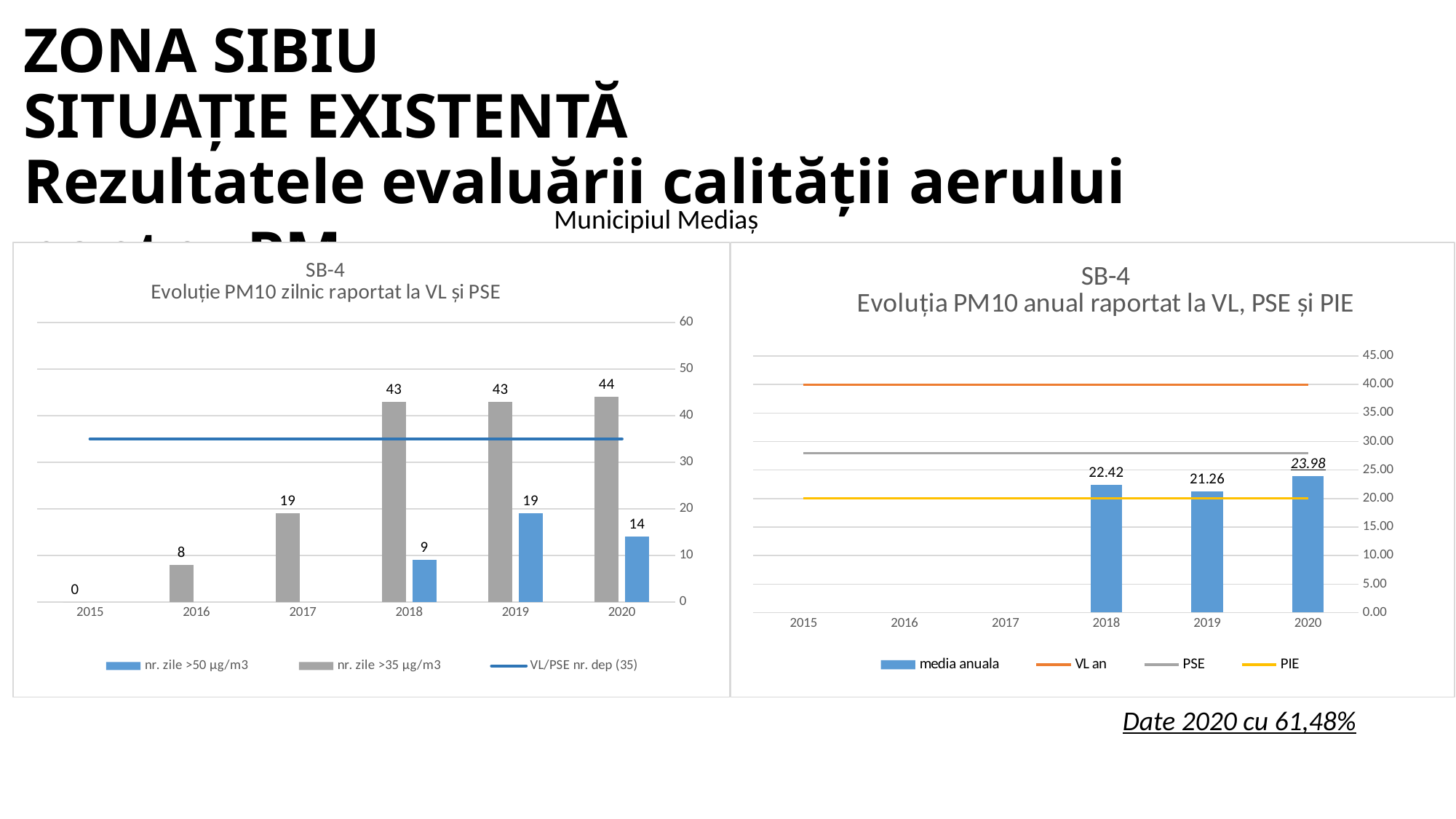
In the right chart (Evoluția PM10 anual raportat la VL, PSE și PIE), is the VL an line greater or less than 35.00? greater In the right chart (Evoluția PM10 anual raportat la VL, PSE și PIE), what colour is the PIE line in the legend? Yellow In the left chart (Evoluție PM10 zilnic raportat la VL și PSE), which year has the highest value for nr. zile >35 µg/m3? 2020 In the left chart (Evoluție PM10 zilnic raportat la VL și PSE), what is the difference between nr. zile >35 µg/m3 and nr. zile >50 µg/m3 in 2018? 34 In the right chart (Evoluția PM10 anual raportat la VL, PSE și PIE), which is larger, the media anuala for 2018 or for 2019? 2018 In the right chart (Evoluția PM10 anual raportat la VL, PSE și PIE), what is the media anuala value for 2019? 21.26 In the right chart (Evoluția PM10 anual raportat la VL, PSE și PIE), which year has the highest media anuala value? 2020 In the left chart (Evoluție PM10 zilnic raportat la VL și PSE), what is the value of nr. zile >35 µg/m3 for 2020? 44 In the left chart (Evoluție PM10 zilnic raportat la VL și PSE), what is the value of nr. zile >50 µg/m3 for 2019? 19 In the left chart (Evoluție PM10 zilnic raportat la VL și PSE), is the value of nr. zile >50 µg/m3 for 2020 greater or less than 20? less In the left chart (Evoluție PM10 zilnic raportat la VL și PSE), how many series does the legend list? 3 In the right chart (Evoluția PM10 anual raportat la VL, PSE și PIE), how many years are shown on the x axis? 6